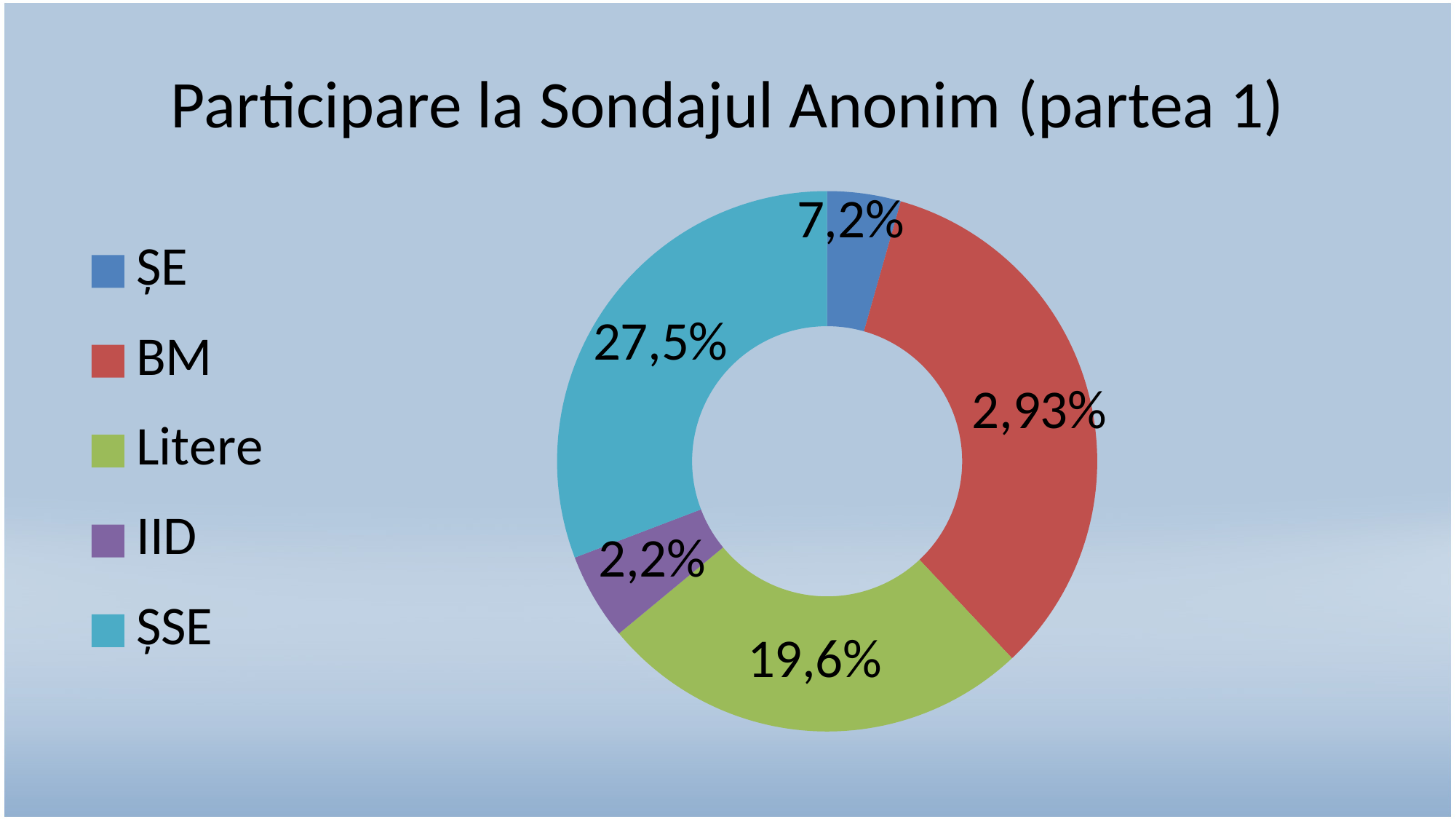
Which colour represents IID in the legend? Purple What is the title of the chart? Participare la Sondajul Anonim (partea 1) What kind of chart is shown on the slide? Doughnut (pie) chart What value is shown for ȘE? 7,2% What is the difference between the values for ȘSE and Litere? 7,9% What value is shown for ȘSE? 27,5% What value is shown for IID? 2,2% What value label is printed on the BM slice? 2,93% How many categories does the legend list? 5 What value is shown for Litere? 19,6% Which is larger, the value for ȘSE or the value for Litere? ȘSE